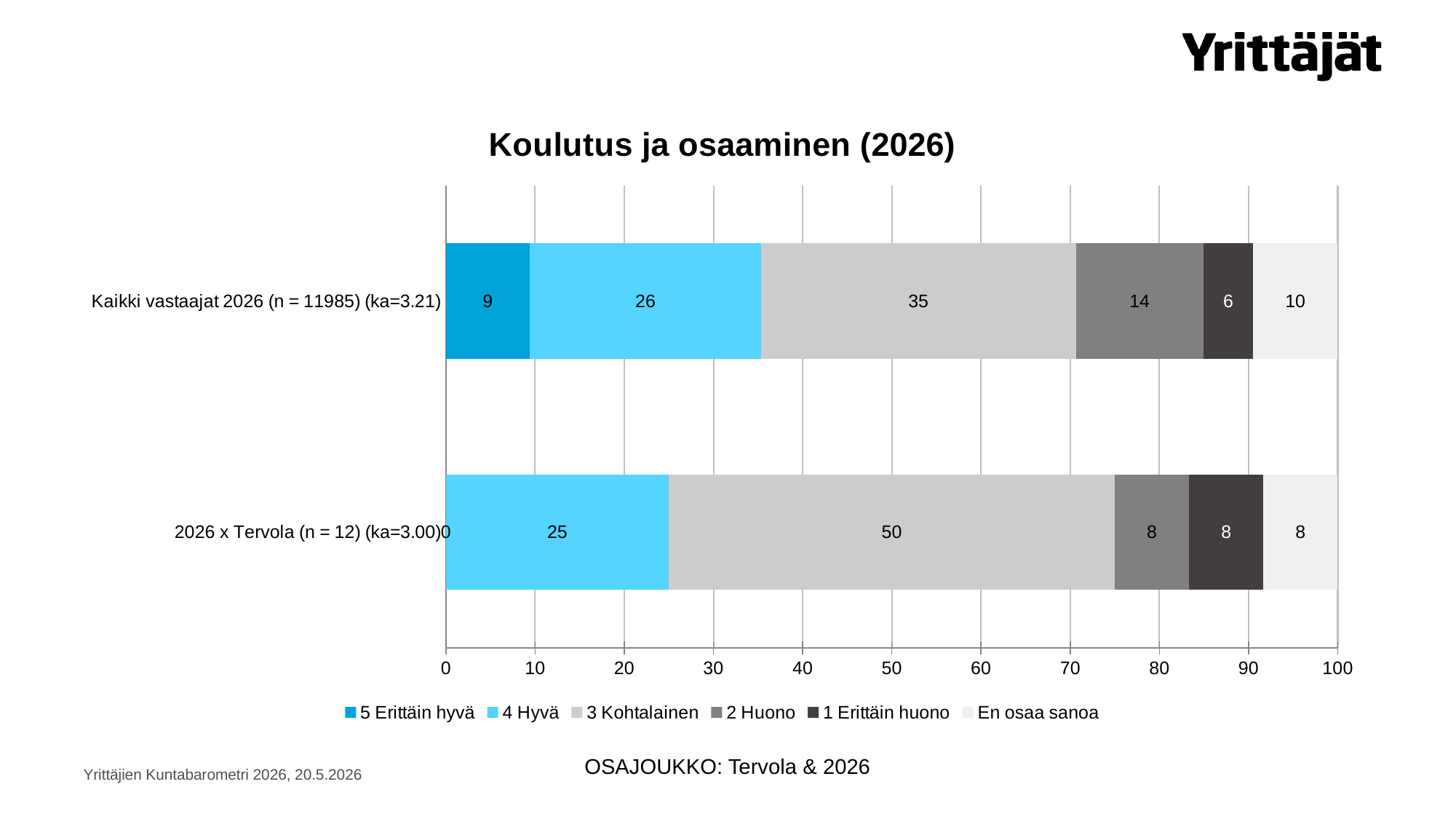
What type of chart is shown on the slide? Stacked bar chart How many series does the legend list? 6 Which category has the larger "2 Huono" value, "Kaikki vastaajat 2026 (n = 11985) (ka=3.21)" or "2026 x Tervola (n = 12) (ka=3.00)"? Kaikki vastaajat 2026 (n = 11985) (ka=3.21) What is the value of "5 Erittäin hyvä" for "Kaikki vastaajat 2026 (n = 11985) (ka=3.21)"? 9 How many categories (bars) are shown in the chart? 2 What is the total of the stacked bar for "2026 x Tervola (n = 12) (ka=3.00)"? 99 What is the value of "5 Erittäin hyvä" for "2026 x Tervola (n = 12) (ka=3.00)"? 0 What is the difference between the "3 Kohtalainen" values for "2026 x Tervola (n = 12) (ka=3.00)" and "Kaikki vastaajat 2026 (n = 11985) (ka=3.21)"? 15 What is the value of "2 Huono" for "Kaikki vastaajat 2026 (n = 11985) (ka=3.21)"? 14 What is the value of "3 Kohtalainen" for "2026 x Tervola (n = 12) (ka=3.00)"? 50 What is the title of the chart? Koulutus ja osaaminen (2026) Which series has the highest value in the "Kaikki vastaajat 2026 (n = 11985) (ka=3.21)" bar? 3 Kohtalainen